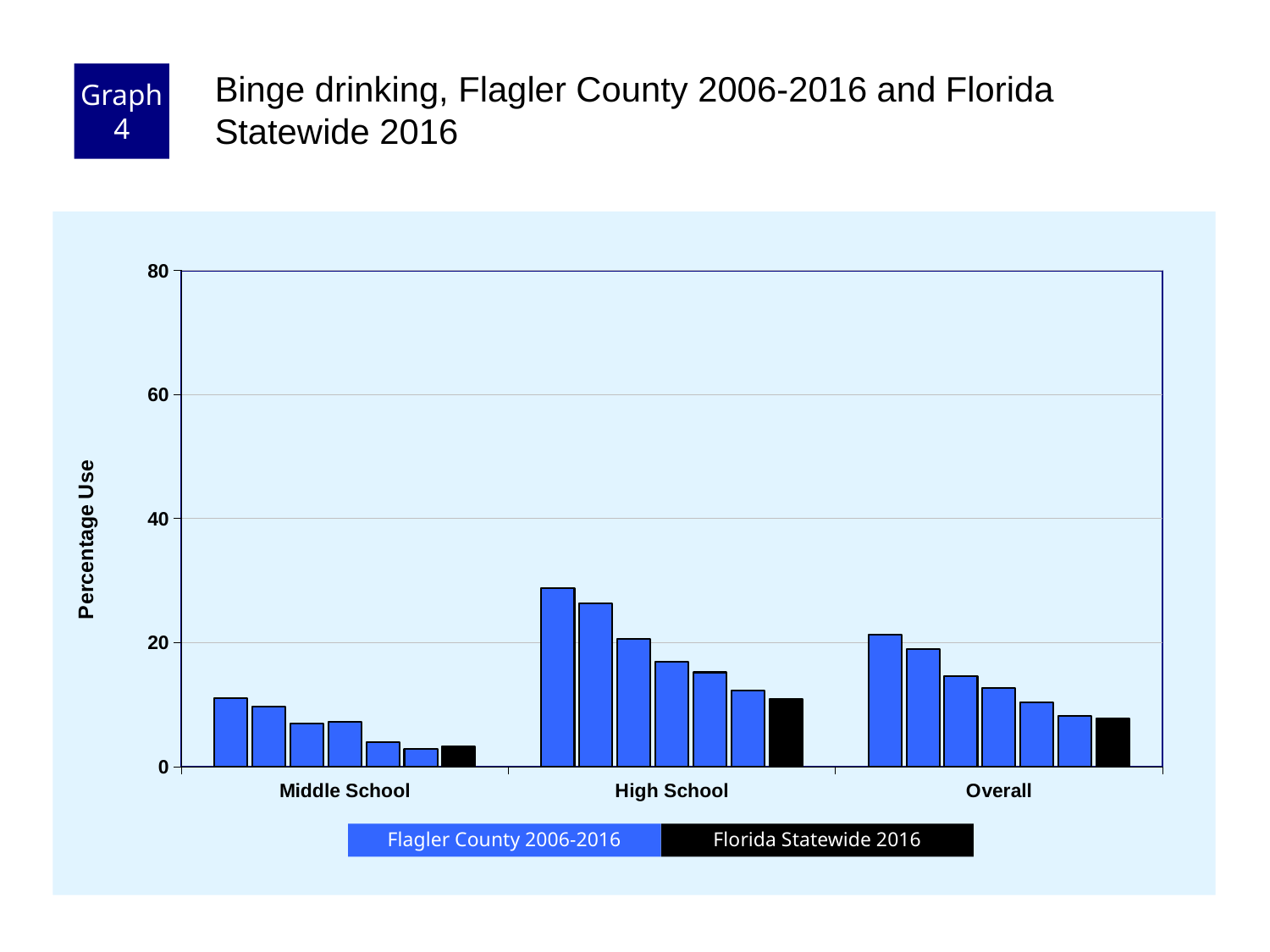
Within each category, do the Flagler County 2006-2016 bars rise or fall from left to right? fall Which category has the tallest bars overall? High School How many school-level categories are shown on the x axis? 3 What kind of chart is shown on the slide? bar chart Which category has the shortest bars overall? Middle School Which is larger: the Florida Statewide 2016 value for High School or for Middle School? High School Is the tallest Flagler County bar for Middle School greater or less than 20? less What is the label on the y axis? Percentage Use Is the Florida Statewide 2016 value for Overall greater or less than 20? less Is the Florida Statewide 2016 value for High School greater or less than 20? less How many series does the legend list? 2